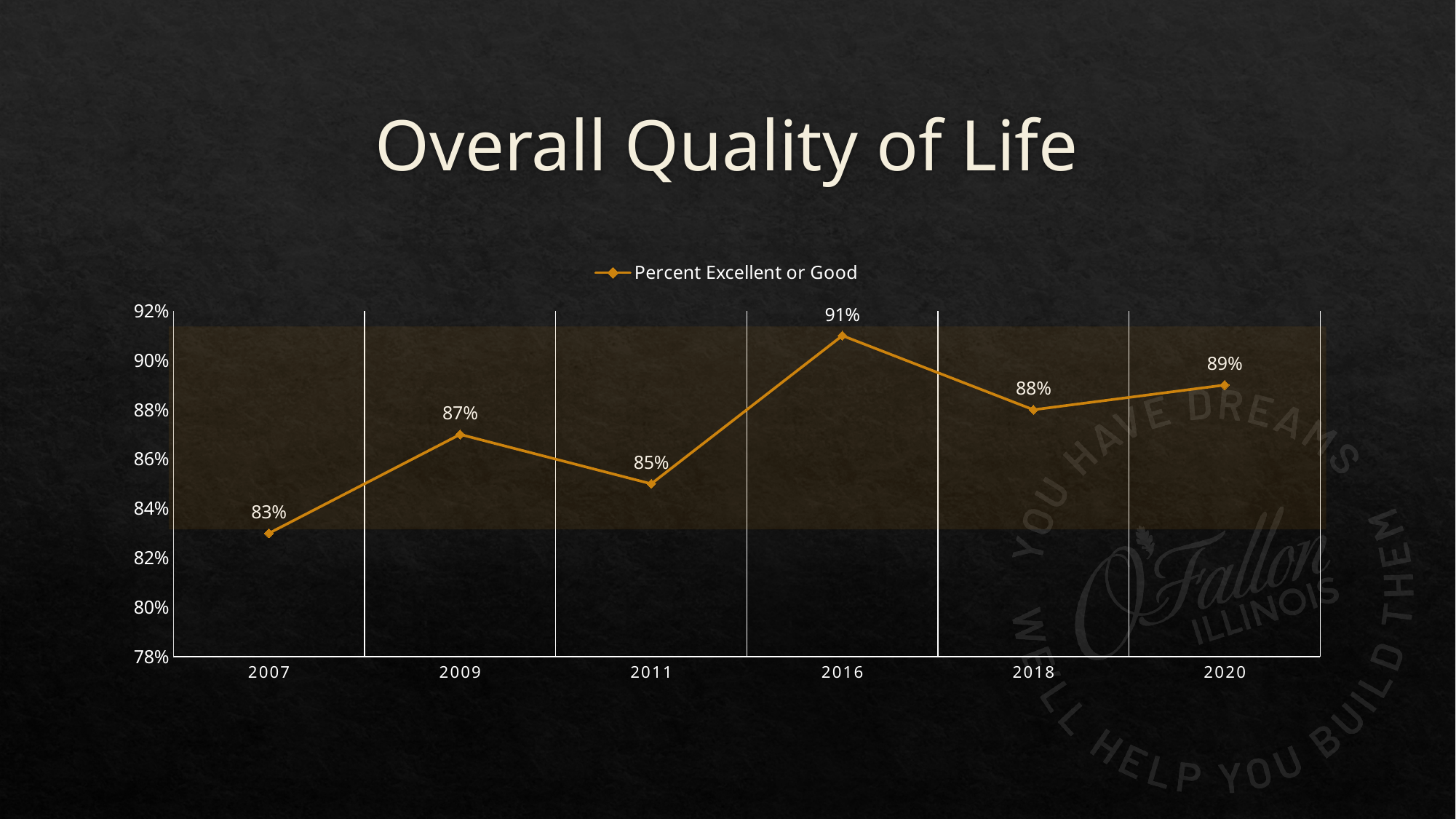
Which year has the lowest value? 2007 How many series does the legend list? 1 Which is larger, the value for 2009 or the value for 2018? 2018 What is the name of the series shown in the legend? Percent Excellent or Good How many years are plotted on the chart? 6 What is the value for 2016? 91% What kind of chart is shown? line chart Which year has the highest value? 2016 Is the value for 2011 greater or less than 86%? less What is the value for 2007? 83% What is the difference between the values for 2016 and 2011? 6% What is the value for 2020? 89%